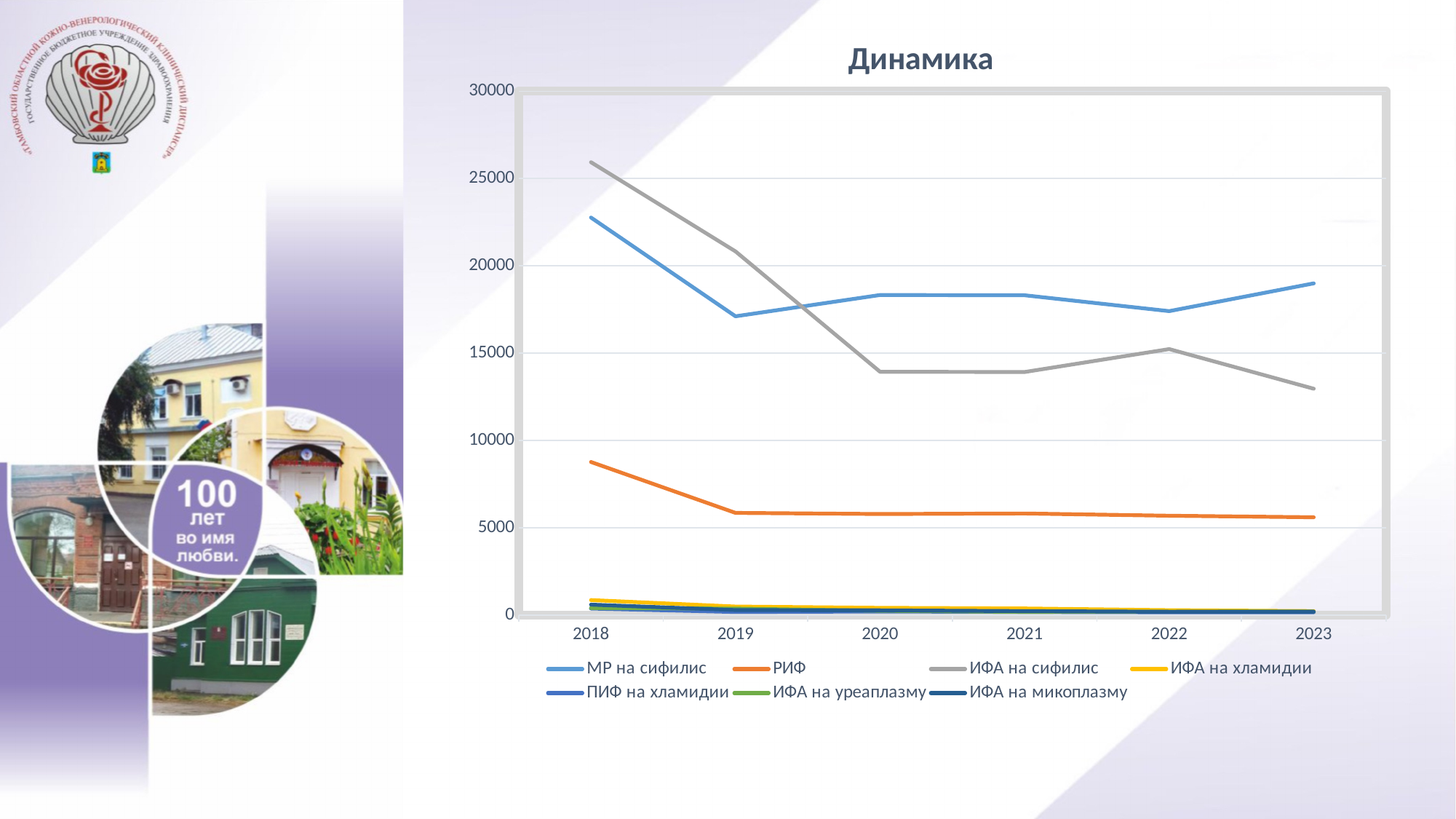
Does the value for РИФ rise or fall from 2018 to 2019? fall Is the value for РИФ in 2023 greater or less than 10000? less Which series has the highest value in 2018? ИФА на сифилис In which year does МР на сифилис reach its highest value? 2018 How many series does the legend list? 7 In 2018, which is higher: ИФА на сифилис or МР на сифилис? ИФА на сифилис In 2023, which is higher: МР на сифилис or ИФА на сифилис? МР на сифилис Is the value for ИФА на сифилис in 2018 greater or less than 25000? greater How many years are shown on the x axis? 6 What kind of chart is shown on the slide? line chart Is the value for МР на сифилис in 2019 greater or less than 15000? greater What is the title of the chart? Динамика